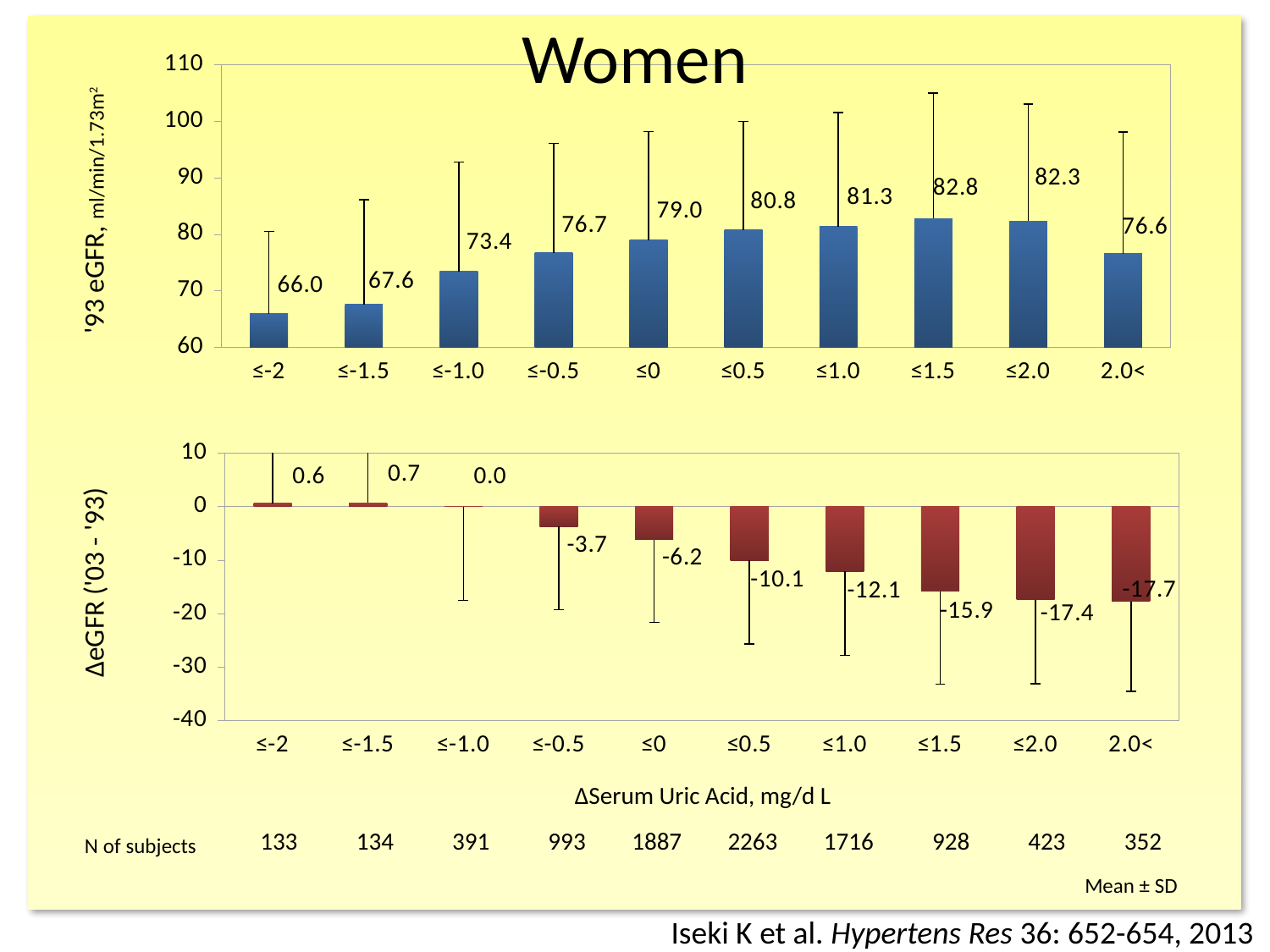
In the top chart ('93 eGFR), what is the value for the ≤0 category? 79.0 What is the x-axis label shared by both charts? ΔSerum Uric Acid, mg/d L In the top chart ('93 eGFR), which category has the lowest value? ≤-2 In the bottom chart (ΔeGFR '03 - '93), do the values generally rise or fall from ≤-0.5 to 2.0< along the x axis? fall In the top chart ('93 eGFR), what is the difference between the values for ≤1.5 and ≤-2? 16.8 In the top chart ('93 eGFR), is the value for ≤-1.0 greater or less than 70? greater How many categories are shown on the x axis of the top chart ('93 eGFR)? 10 In the bottom chart (ΔeGFR '03 - '93), which category has the lowest value? 2.0< In the bottom chart (ΔeGFR '03 - '93), what is the value for the ≤1.0 category? -12.1 In the bottom chart (ΔeGFR '03 - '93), which is larger, the value for ≤-0.5 or the value for ≤0.5? ≤-0.5 In the top chart ('93 eGFR), which category has the highest value? ≤1.5 What kind of chart is the bottom chart (ΔeGFR '03 - '93)? bar chart